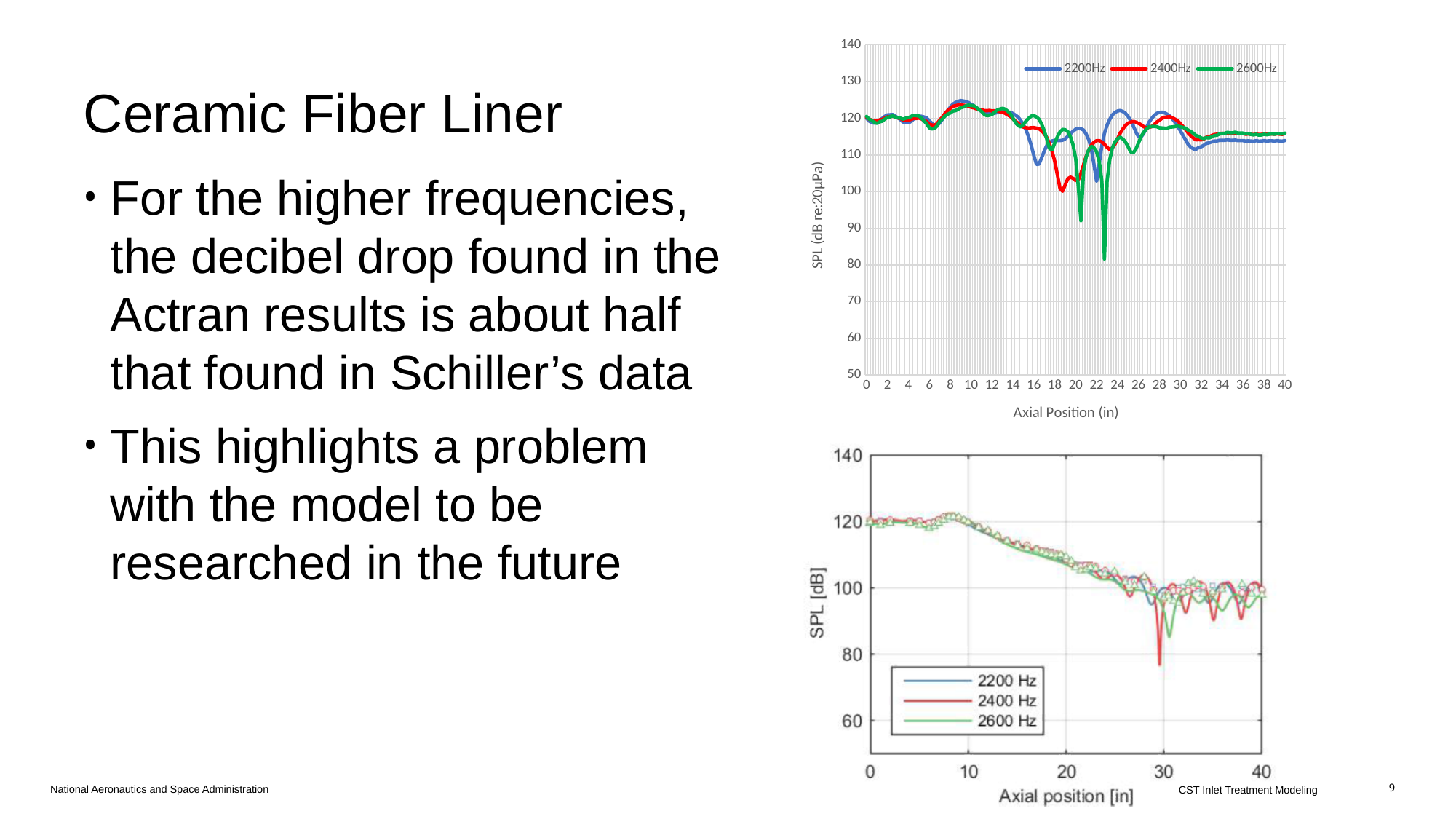
What kind of chart is the top chart? line chart On the bottom chart, how many series does the legend list? 3 On the top chart, is the lowest value reached by the 2600Hz series greater or less than 90? less What kind of chart is the bottom chart? line chart On the top chart, is the value of the 2200Hz series at axial position 0 greater or less than 110? greater On the bottom chart, which series reaches the lowest SPL value? 2400 Hz On the bottom chart, do the SPL values overall rise or fall as axial position increases from 0 to 40? fall On the top chart, how many series does the legend list? 3 On the bottom chart, is the lowest value reached by the 2400 Hz series greater or less than 80? less On the top chart, which series reaches the lowest SPL value? 2600Hz What is the x-axis label of the top chart? Axial Position (in) What is the y-axis label of the bottom chart? SPL [dB]